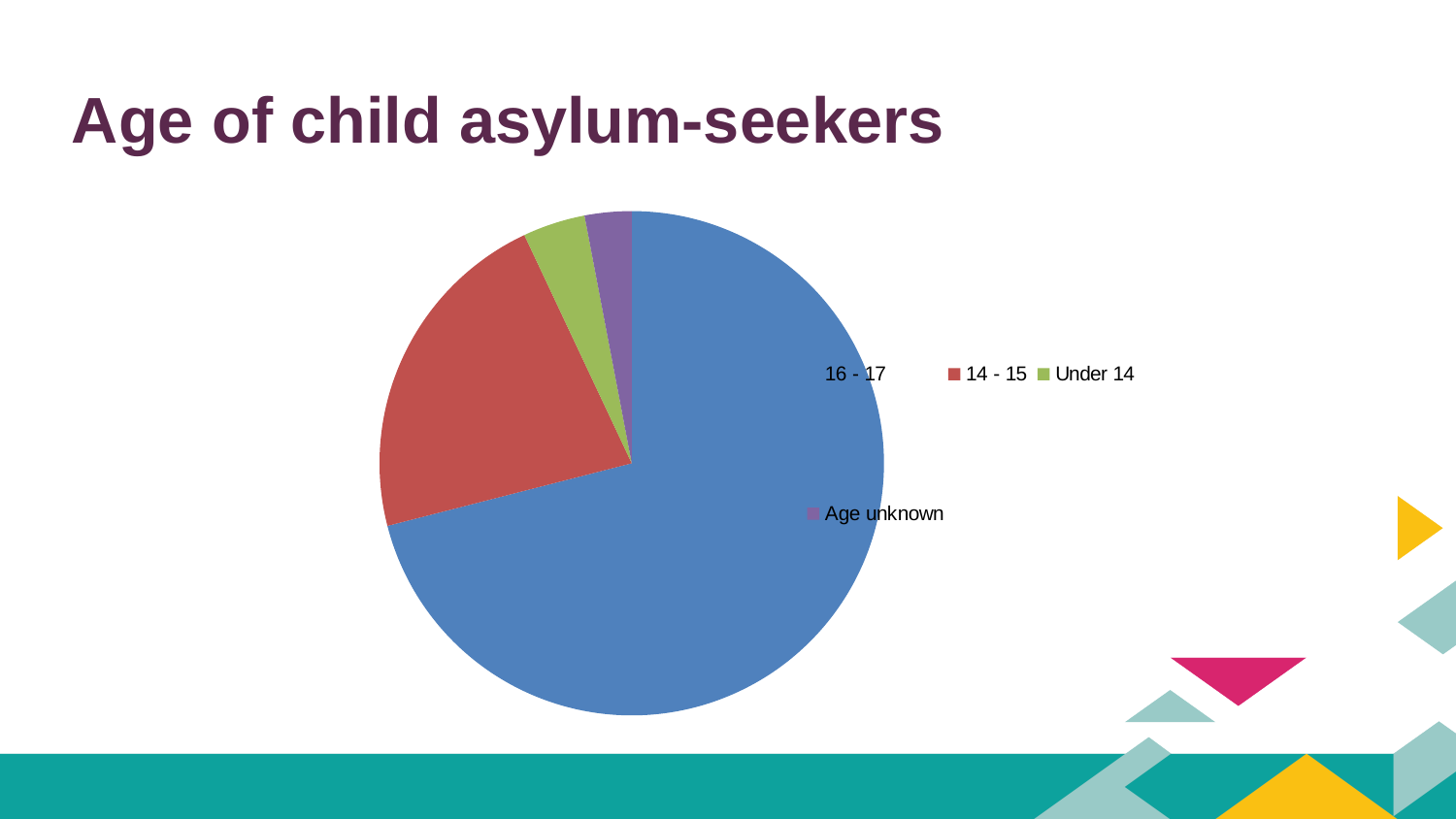
What colour is the 16 - 17 slice in the pie chart? blue Which age group has the largest slice of the pie chart? 16 - 17 Which slice is larger, 14 - 15 or Age unknown? 14 - 15 What kind of chart is shown on the slide? pie chart Which slice is larger, 16 - 17 or 14 - 15? 16 - 17 Does the 16 - 17 slice take up more or less than half of the pie? more How many slices does the pie chart have? 4 What is the title of the slide containing the pie chart? Age of child asylum-seekers Which slice is larger, 14 - 15 or Under 14? 14 - 15 How many entries does the legend of the pie chart list? 4